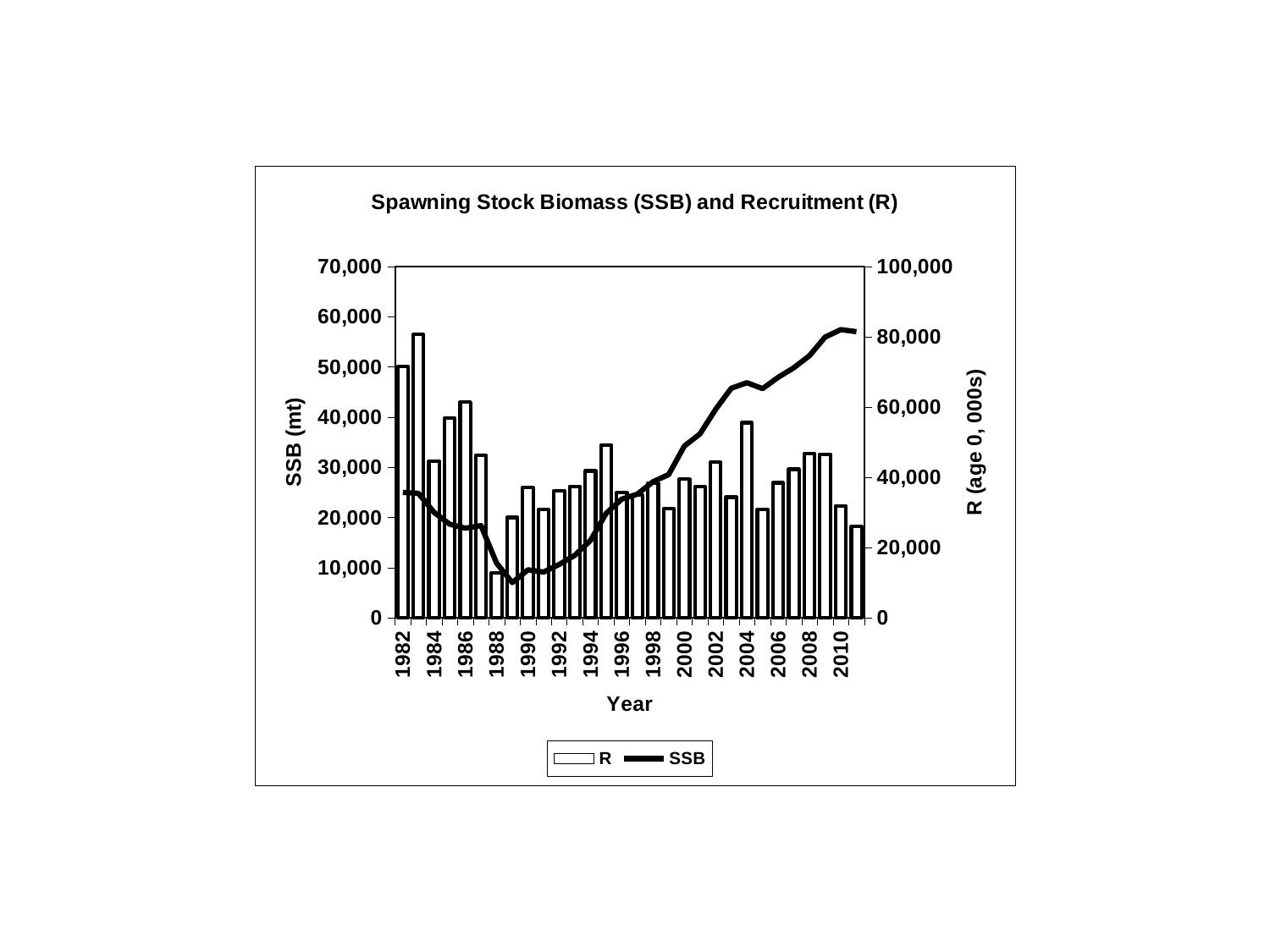
In which year is recruitment (R) highest? 1983 Is the SSB value for 2011 greater or less than 50,000? greater What is the label on the right-hand vertical axis? R (age 0, 000s) Is the recruitment (R) value for 1982 greater or less than 60,000? greater How many series does the legend list? 2 In which year is recruitment (R) lowest? 1988 Does the SSB line rise or fall from 1990 to 2011? Rises What kind of chart is shown on the slide? A combination bar and line chart Which year has the larger recruitment (R) value, 1983 or 2004? 1983 In which year is spawning stock biomass (SSB) lowest? 1989 How many years are plotted along the x axis? 30 Is the SSB value for 1982 greater or less than 30,000? less